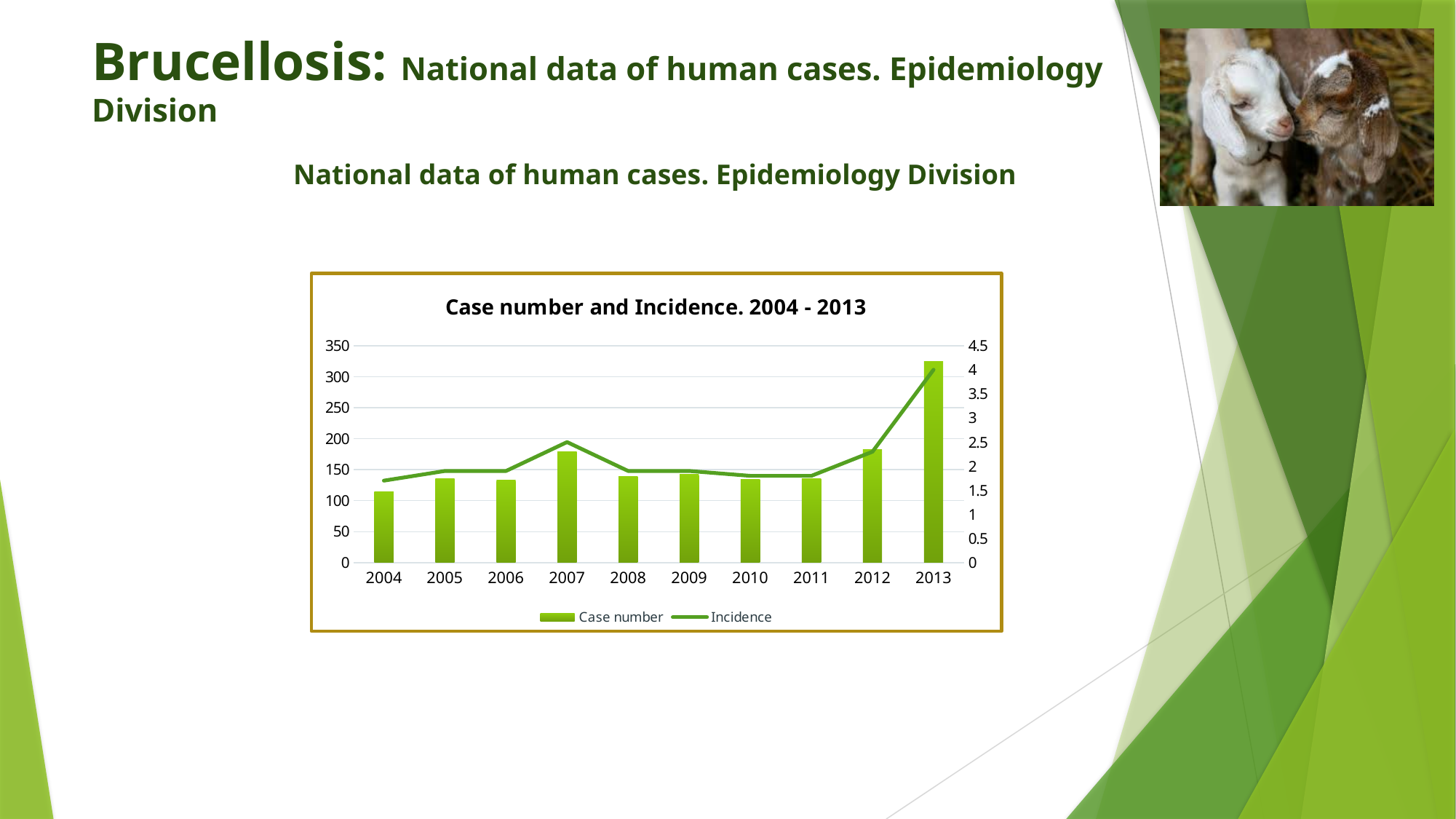
Which year has the lowest case number? 2004 Which year has the highest case number? 2013 Is the case number for 2013 greater or less than 300? greater Which series is drawn as a line in the chart? Incidence How many series does the chart legend list? 2 What kind of chart is shown on the slide? Combined bar and line chart Is the incidence for 2013 greater or less than 3.5? greater How many years are shown on the x axis of the chart? 10 What is the title of the chart? Case number and Incidence. 2004 - 2013 Does the incidence rise or fall from 2012 to 2013? rise Is the case number for 2004 greater or less than 150? less Which year has a higher case number, 2007 or 2012? 2012